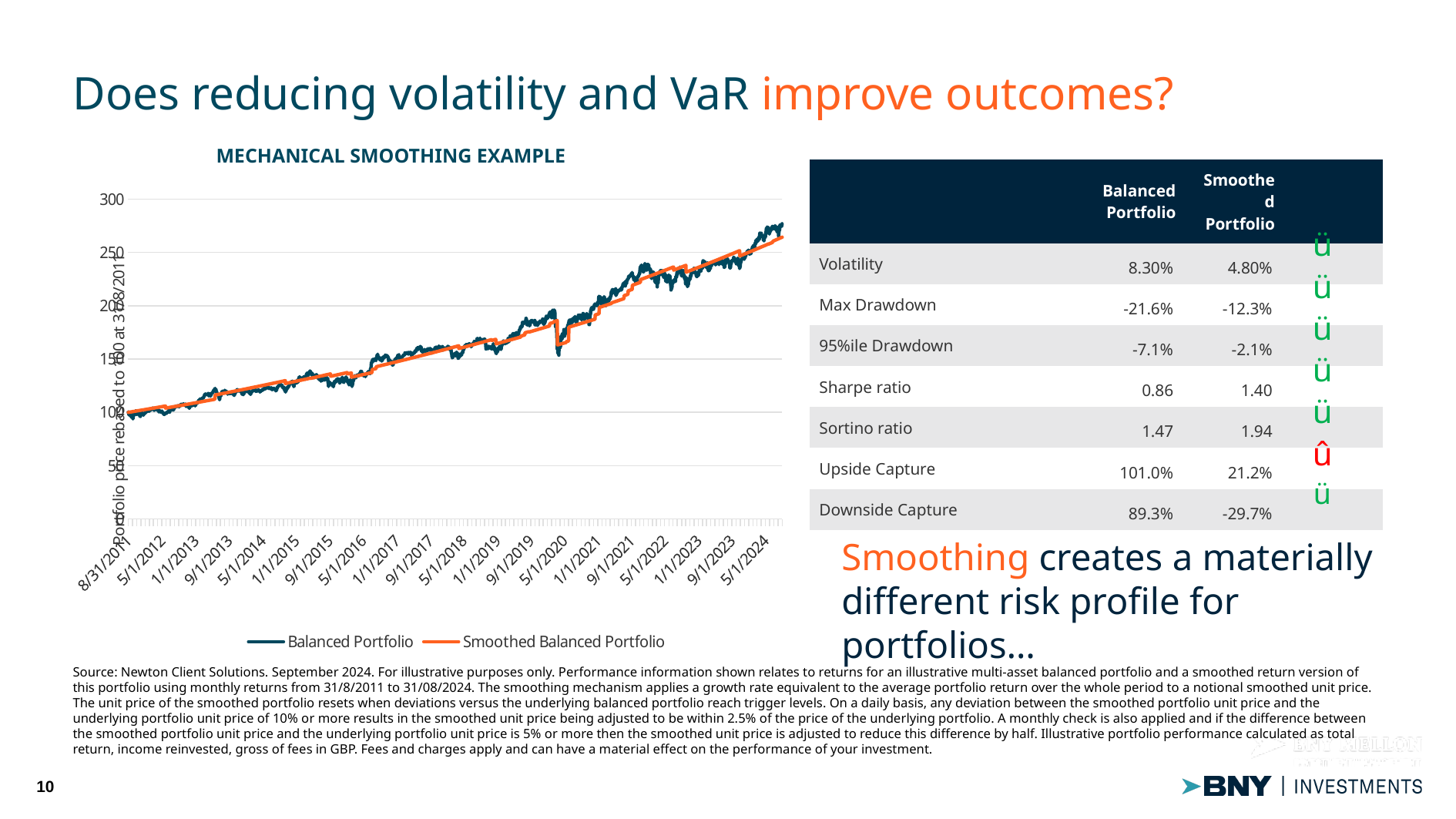
In the MECHANICAL SMOOTHING EXAMPLE chart, is the Balanced Portfolio value at 5/1/2024 greater or less than 250? greater In the MECHANICAL SMOOTHING EXAMPLE chart, is the Smoothed Balanced Portfolio value at 9/1/2022 greater or less than 200? greater How many series does the legend of the MECHANICAL SMOOTHING EXAMPLE chart list? 2 In the MECHANICAL SMOOTHING EXAMPLE chart, is the Balanced Portfolio value at 8/31/2011 greater or less than 150? less In the MECHANICAL SMOOTHING EXAMPLE chart, what colour is the Smoothed Balanced Portfolio line? Orange What is the title of the chart on the left of the slide? MECHANICAL SMOOTHING EXAMPLE In the MECHANICAL SMOOTHING EXAMPLE chart, what is the highest value shown on the vertical axis? 300 In the MECHANICAL SMOOTHING EXAMPLE chart, which series drops lower during the sharp dip around 5/1/2020, Balanced Portfolio or Smoothed Balanced Portfolio? Balanced Portfolio What kind of chart is shown under the heading MECHANICAL SMOOTHING EXAMPLE? Line chart In the MECHANICAL SMOOTHING EXAMPLE chart, do the portfolio values generally rise or fall from 2011 to 2024? Rise